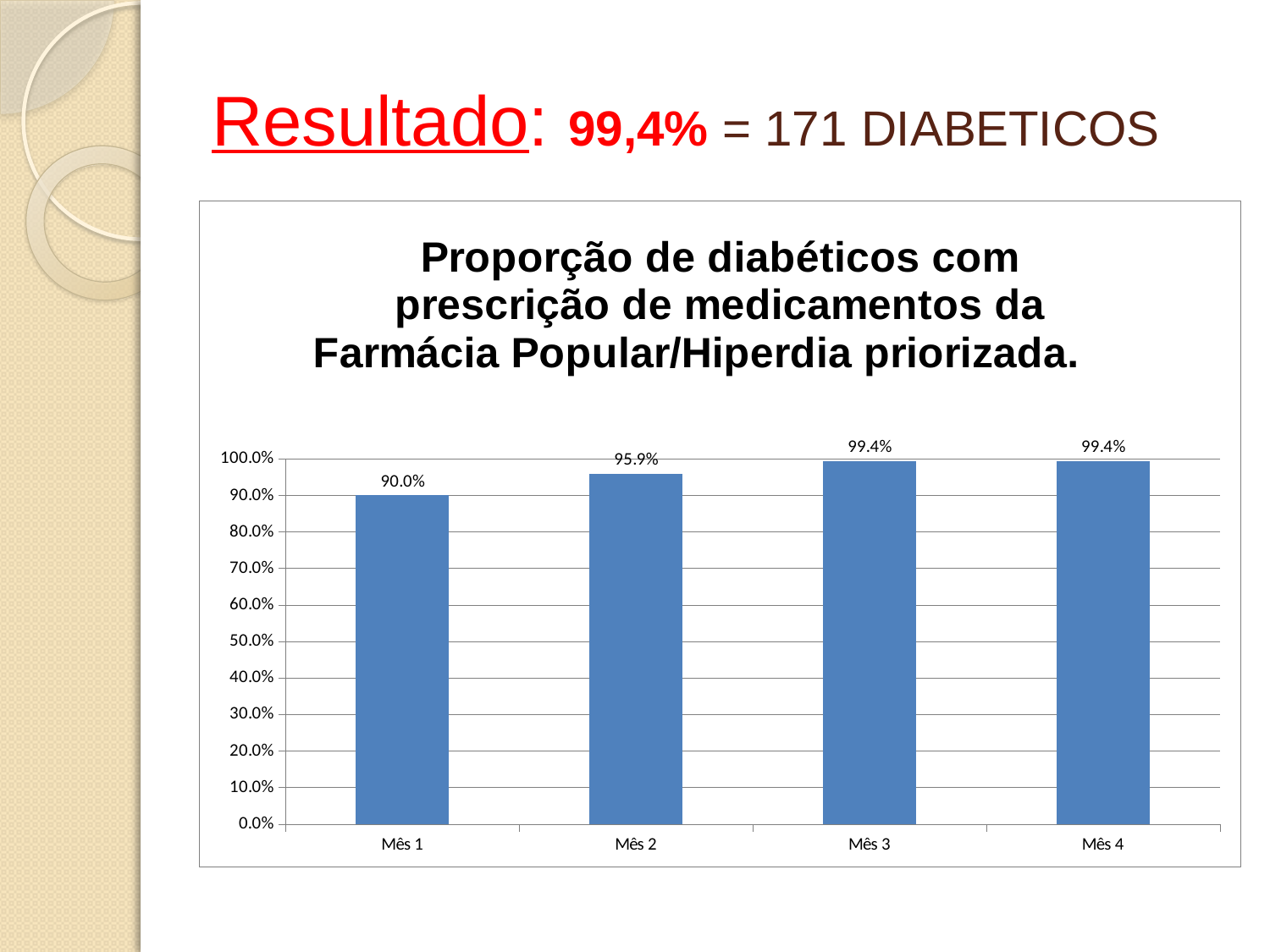
Which is larger, the value for Mês 1 or the value for Mês 2? Mês 2 What kind of chart is shown on the slide? bar chart What is the value for Mês 3? 99.4% Do the values rise or fall from Mês 1 to Mês 3? rise How many months are shown on the x axis? 4 What is the value for Mês 4? 99.4% Is the value for Mês 1 greater or less than 80.0%? greater Which month has the lowest value? Mês 1 What is the difference between the values for Mês 2 and Mês 1? 5.9% What is the value for Mês 2? 95.9% What is the value for Mês 1? 90.0% What is the difference between the values for Mês 3 and Mês 2? 3.5%